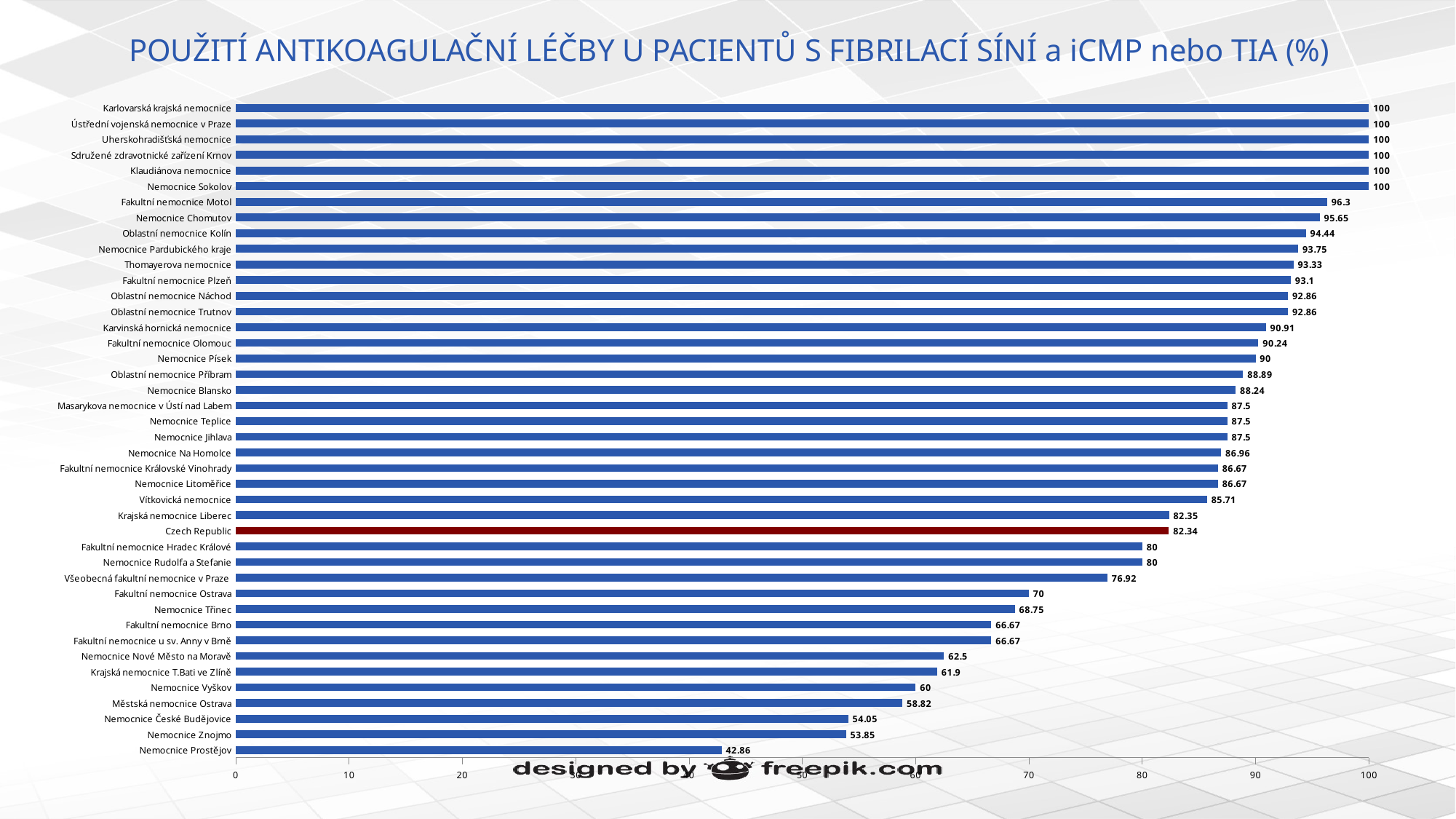
Is the value for Městská nemocnice Ostrava greater or less than 60? less What is the value for Czech Republic? 82.34 What kind of chart is shown on the slide? bar chart Which bar is shown in a different colour (dark red) from the others? Czech Republic Which hospital has the lowest value? Nemocnice Prostějov Which is larger, the value for Nemocnice Třinec or the value for Nemocnice Vyškov? Nemocnice Třinec How many bars have a value of 100? 6 How many hospitals/categories are plotted on the chart? 42 What is the value for Všeobecná fakultní nemocnice v Praze? 76.92 What is the difference between the values for Nemocnice Chomutov and Nemocnice Znojmo? 41.8 What is the value for Nemocnice Prostějov? 42.86 What is the value for Fakultní nemocnice Motol? 96.3